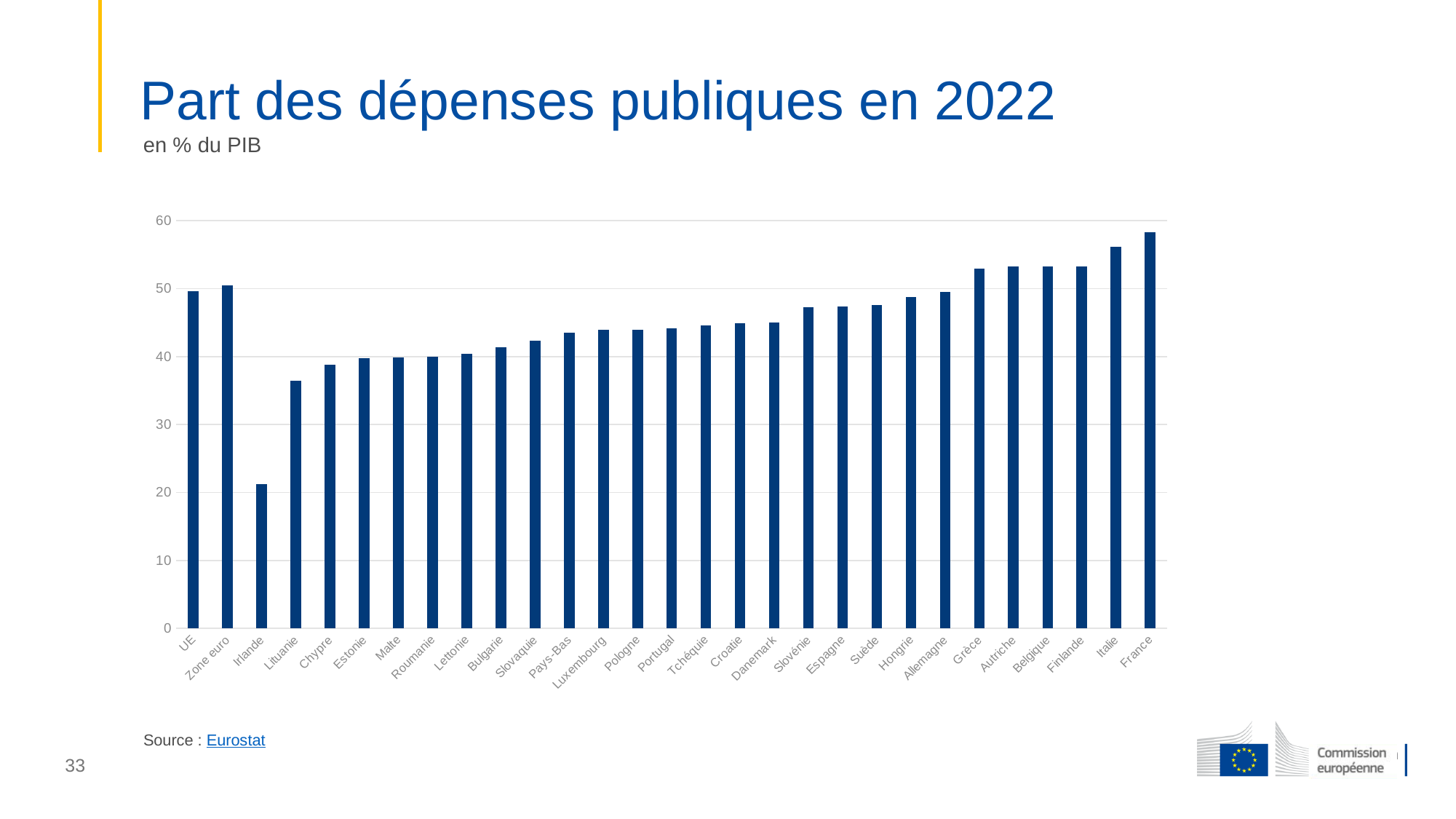
What is the title of the chart on the slide? Part des dépenses publiques en 2022 Which is larger, the value for Irlande or the value for Lituanie? Lituanie Is the value for France greater or less than 50? greater Which is larger, the value for France or the value for Italie? France Is the value for Lituanie greater or less than 40? less Which country has the highest share of public expenditure in the chart? France Is the value for Irlande greater or less than 30? less What kind of chart is shown on the slide? Bar chart How many bars are plotted in the chart? 29 Which country has the lowest share of public expenditure in the chart? Irlande Do the values for the countries from Irlande to France rise or fall along the x axis? Rise